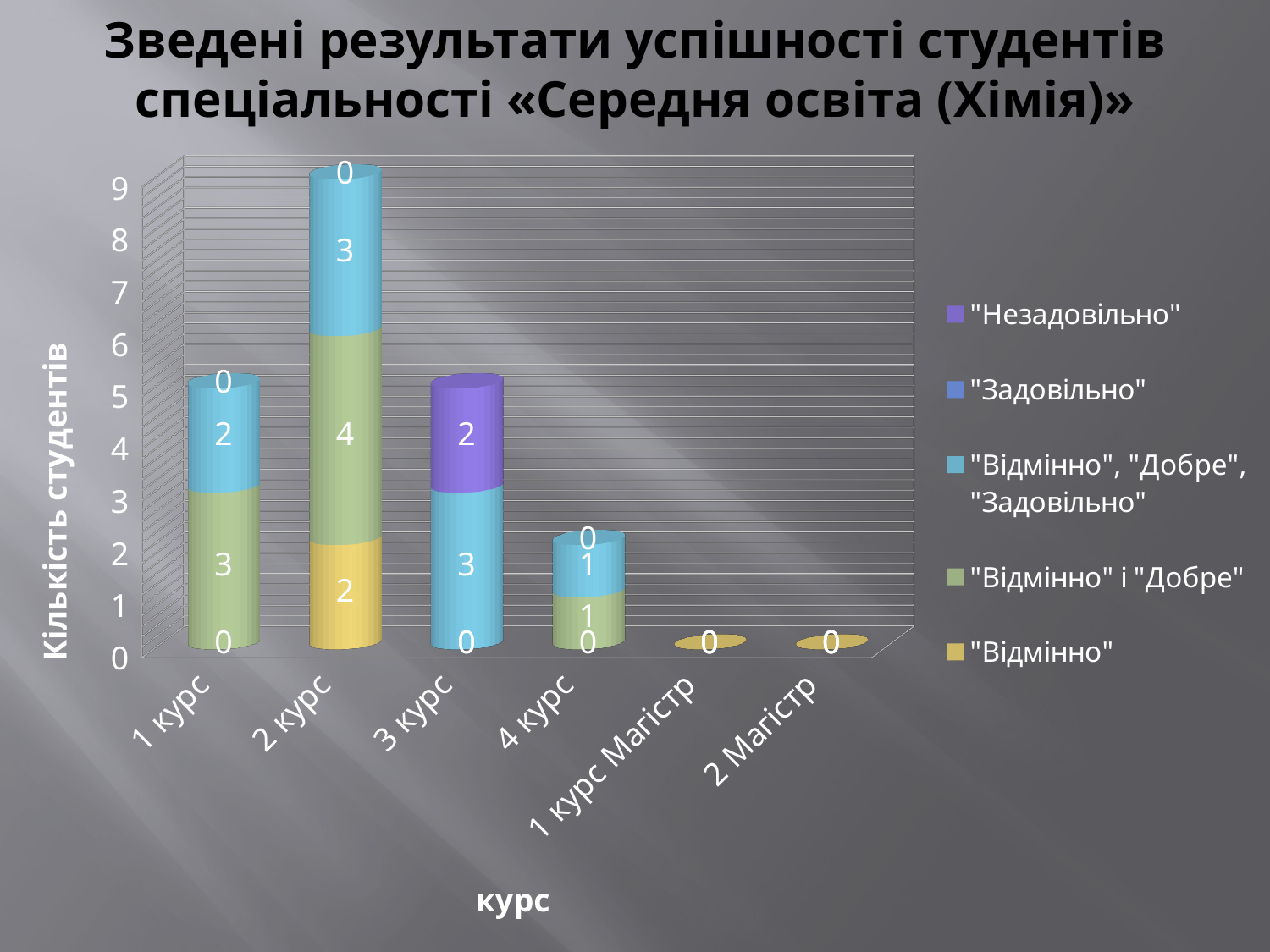
What is the label of the y axis? Кількість студентів How many series does the legend list? 5 What is the value of the "Незадовільно" segment for 3 курс? 2 What type of chart is shown on the slide? stacked bar chart What is the total of the stacked bar for 2 курс? 9 What is the value of the "Відмінно", "Добре", "Задовільно" segment for 1 курс? 2 What is the value of the "Відмінно" і "Добре" segment for 2 курс? 4 Which is larger: the "Відмінно" і "Добре" value for 1 курс or for 4 курс? 1 курс How many categories are shown on the x axis? 6 What is the value of the "Відмінно" segment for 2 курс? 2 What is the difference between the "Відмінно" і "Добре" values for 2 курс and 4 курс? 3 Which category has the tallest stacked bar? 2 курс